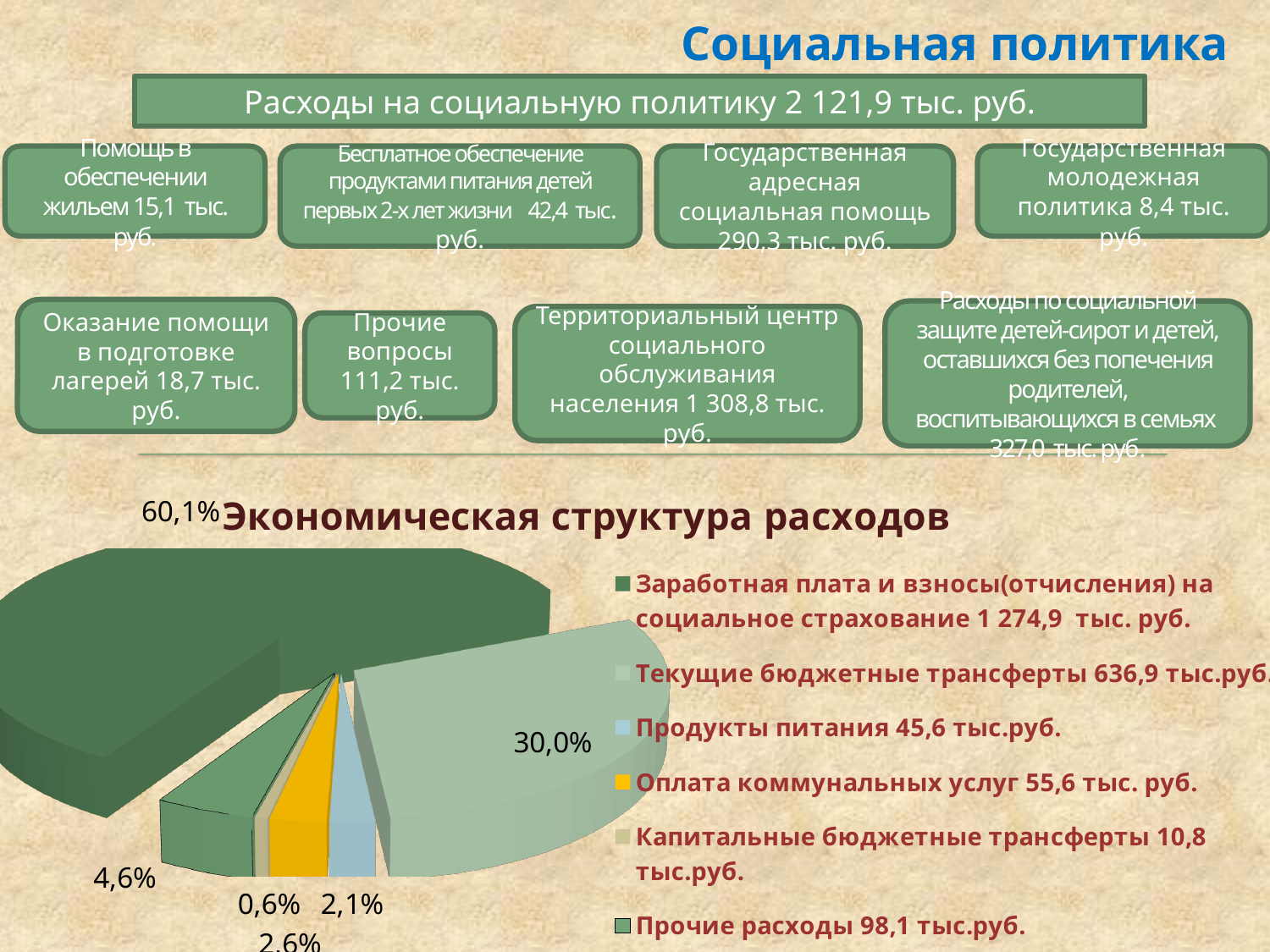
Which category has the largest slice in the pie chart? Заработная плата и взносы(отчисления) на социальное страхование What share of the pie chart is labelled for "Прочие расходы"? 4,6% Which slice is larger in the pie chart: "Оплата коммунальных услуг" or "Продукты питания"? Оплата коммунальных услуг According to the legend of the pie chart, what amount is given for "Текущие бюджетные трансферты"? 636,9 тыс.руб. Which category has the smallest slice in the pie chart? Капитальные бюджетные трансферты What colour is the slice for "Оплата коммунальных услуг" in the pie chart? yellow How many slices does the pie chart "Экономическая структура расходов" have? 6 What is the difference in percentage points between the largest slice (60,1%) and the second largest slice (30,0%) in the pie chart? 30,1 What kind of chart is shown under the heading "Экономическая структура расходов"? pie chart According to the legend of the pie chart, what amount is given for "Прочие расходы"? 98,1 тыс.руб. What share of the pie chart is labelled for "Текущие бюджетные трансферты"? 30,0% What share of the pie chart is labelled for "Заработная плата и взносы(отчисления) на социальное страхование"? 60,1%